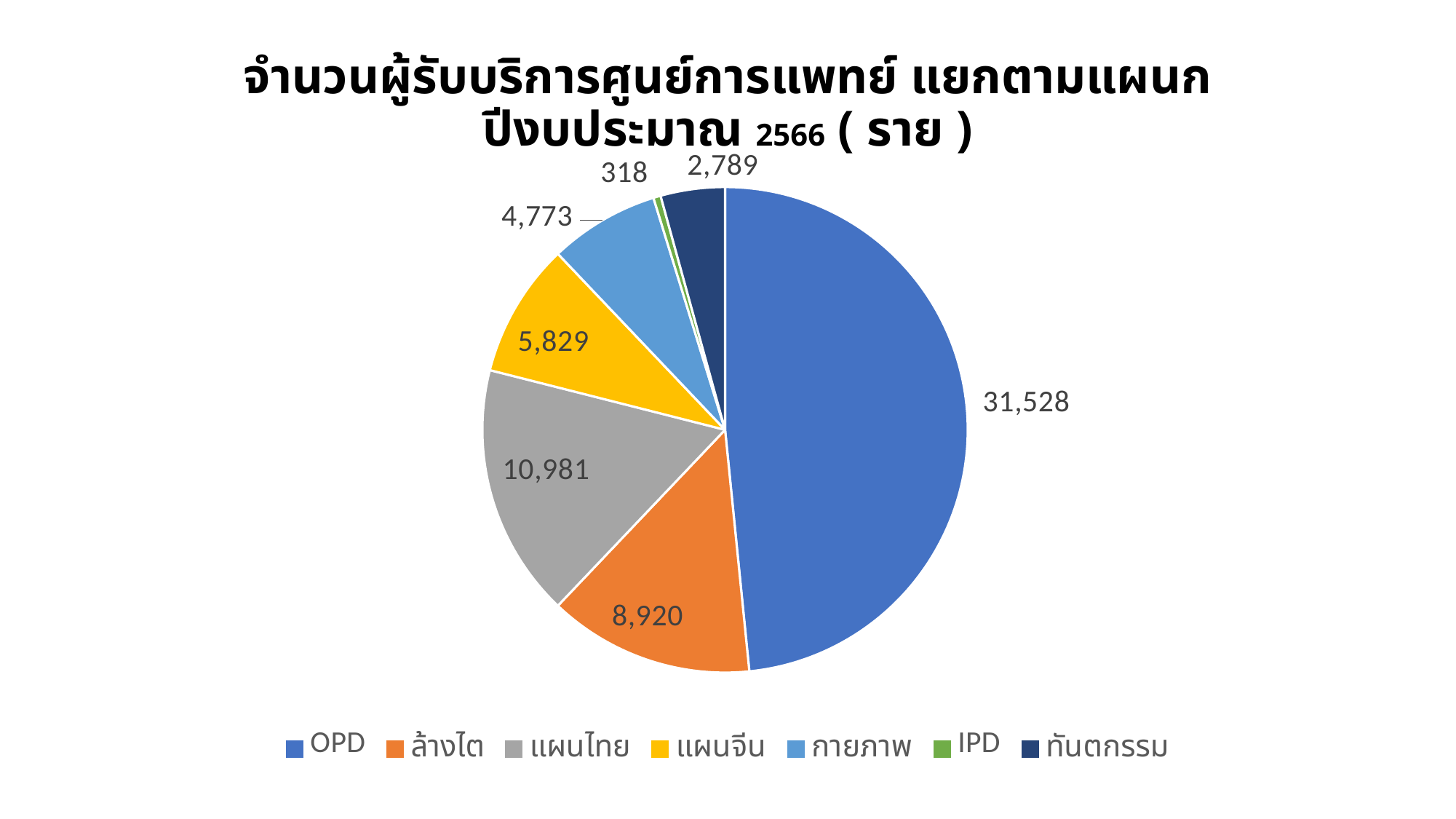
What is the value for ล้างไต? 8,920 Which department has the smallest slice of the pie? IPD Which department has the largest slice of the pie? OPD How many departments are listed in the legend? 7 What is the value for ทันตกรรม? 2,789 What is the value for แผนไทย? 10,981 Which is larger, the value for แผนไทย or the value for ล้างไต? แผนไทย What is the value for OPD? 31,528 What is the difference between the values for แผนจีน and กายภาพ? 1,056 What is the value for IPD? 318 What type of chart is shown on the slide? pie chart What is the difference between the values for OPD and แผนไทย? 20,547